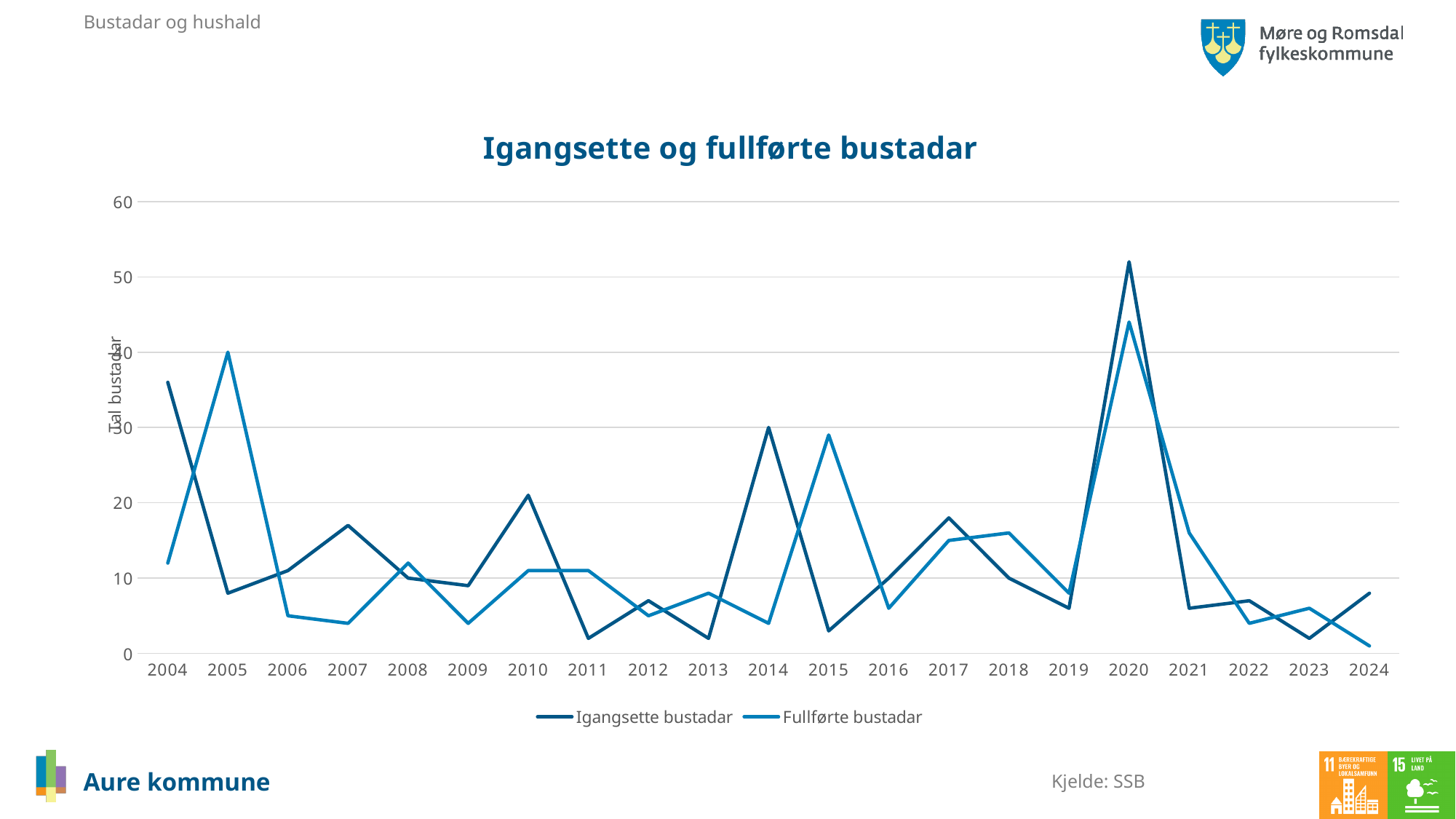
In 2014, which series has the larger value, Igangsette bustadar or Fullførte bustadar? Igangsette bustadar How many series does the legend list? 2 Does the Igangsette bustadar series rise or fall from 2020 to 2023? fall In which year does the Fullførte bustadar series reach its highest value? 2020 What is the title of the chart? Igangsette og fullførte bustadar How many years are plotted along the x axis? 21 What kind of chart is shown on the slide? line chart In 2005, which series has the larger value, Igangsette bustadar or Fullførte bustadar? Fullførte bustadar Is the value for Igangsette bustadar in 2004 greater or less than 30? greater In which year does the Igangsette bustadar series reach its highest value? 2020 Is the value for Fullførte bustadar in 2005 greater or less than 30? greater Is the value for Igangsette bustadar in 2021 greater or less than 10? less